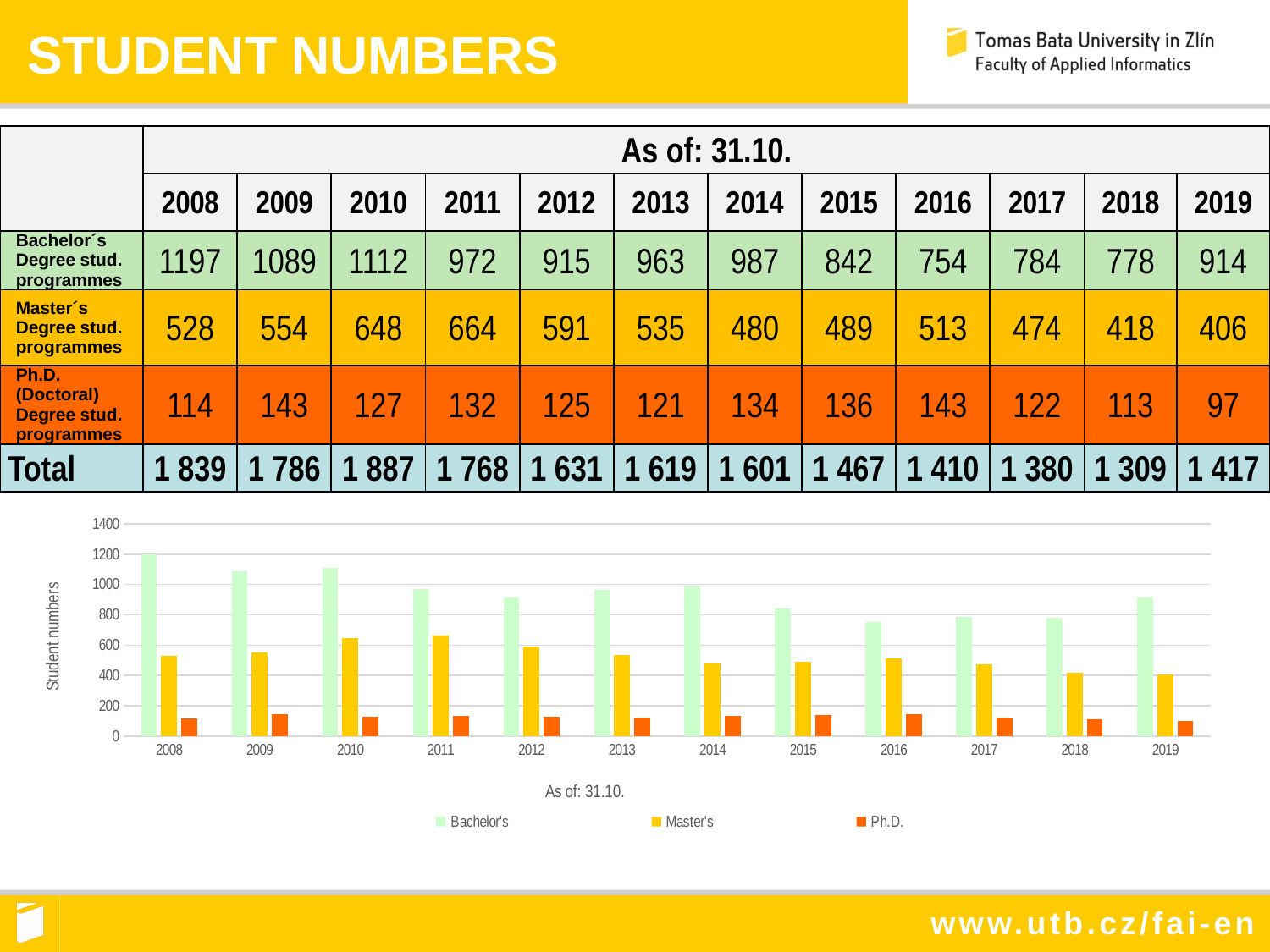
What kind of chart is shown on the slide? bar chart What is the difference between the Bachelor's value in 2008 and in 2019? 283 What is the Master's value for 2011? 664 In which year is the Master's value lowest? 2019 How many years are shown along the x axis of the chart? 12 How many series does the chart legend list? 3 What is the Bachelor's value for 2008? 1197 Which is larger, the Master's value in 2010 or in 2018? 2010 What is the label on the y axis of the chart? Student numbers What is the Ph.D. value for 2019? 97 In which year is the Bachelor's value highest? 2008 Is the Bachelor's value for 2016 greater or less than 800? less